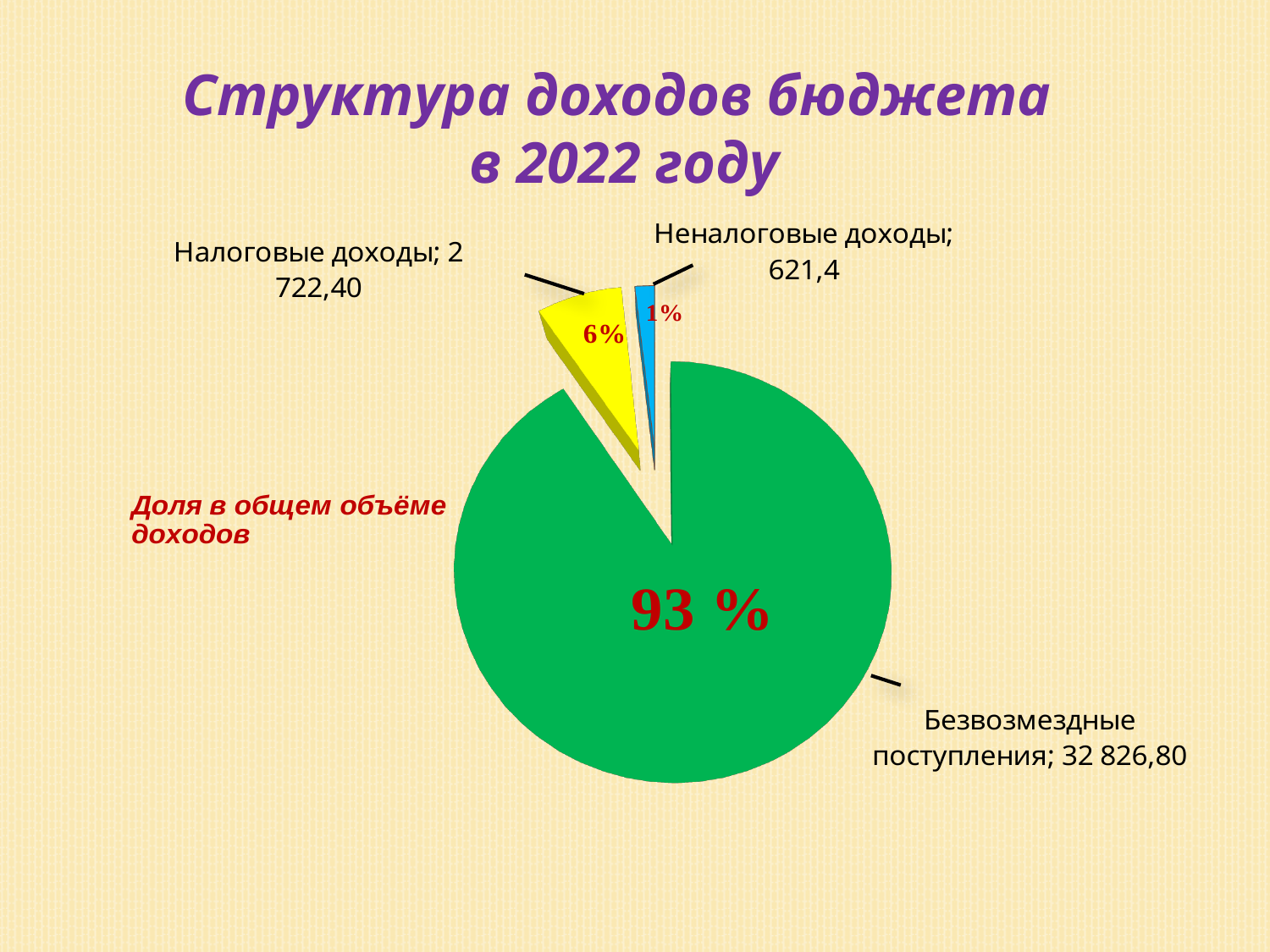
How many slices does the pie chart have? 3 Which category has the smallest slice of the pie? Неналоговые доходы What is the value for Налоговые доходы? 2 722,40 Which category has the largest slice of the pie? Безвозмездные поступления What is the value for Безвозмездные поступления? 32 826,80 What share of the pie does Налоговые доходы take? 6% What kind of chart is shown on the slide? pie chart What is the title of the chart on the slide? Структура доходов бюджета в 2022 году What share of the pie does Безвозмездные поступления take? 93 % What is the difference between Безвозмездные поступления and Налоговые доходы? 30 104,40 Which is larger, Налоговые доходы or Неналоговые доходы? Налоговые доходы What is the value for Неналоговые доходы? 621,4